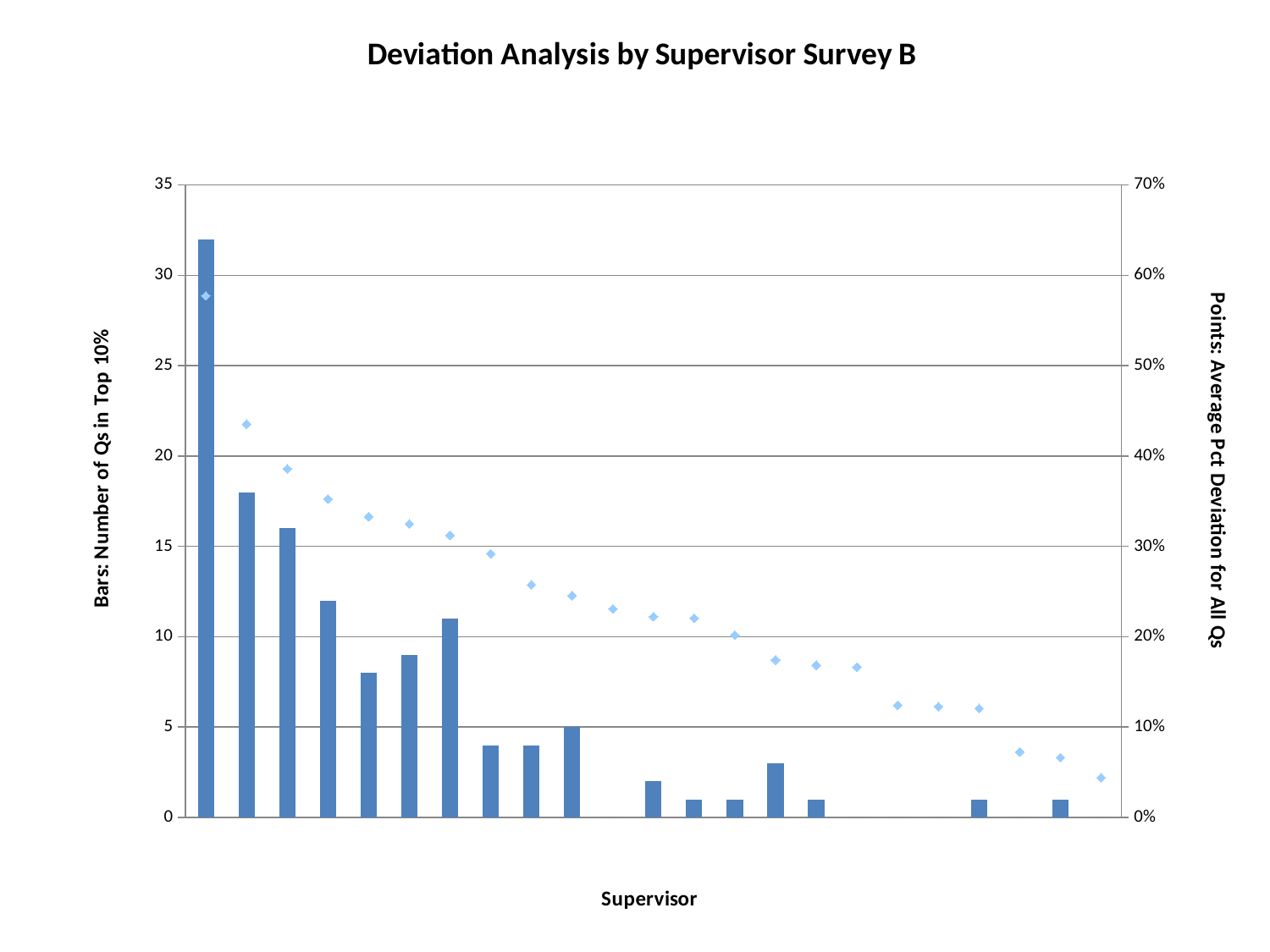
Is the value of the leftmost bar greater or less than 30? greater What is the title of the left vertical axis? Bars: Number of Qs in Top 10% What is the title of the chart? Deviation Analysis by Supervisor Survey B Is the value of the leftmost point greater or less than 50%? greater Do the plotted points (Average Pct Deviation) rise or fall from left to right along the x axis? fall Which bar is the tallest: the leftmost bar or the second bar from the left? the leftmost bar Is the value of the rightmost point greater or less than 10%? less Where on the x axis is the tallest bar located? at the far left What kind of chart is this? A bar chart combined with a scatter of points on a secondary axis What is the highest value shown on the right-hand (percentage) axis? 70%